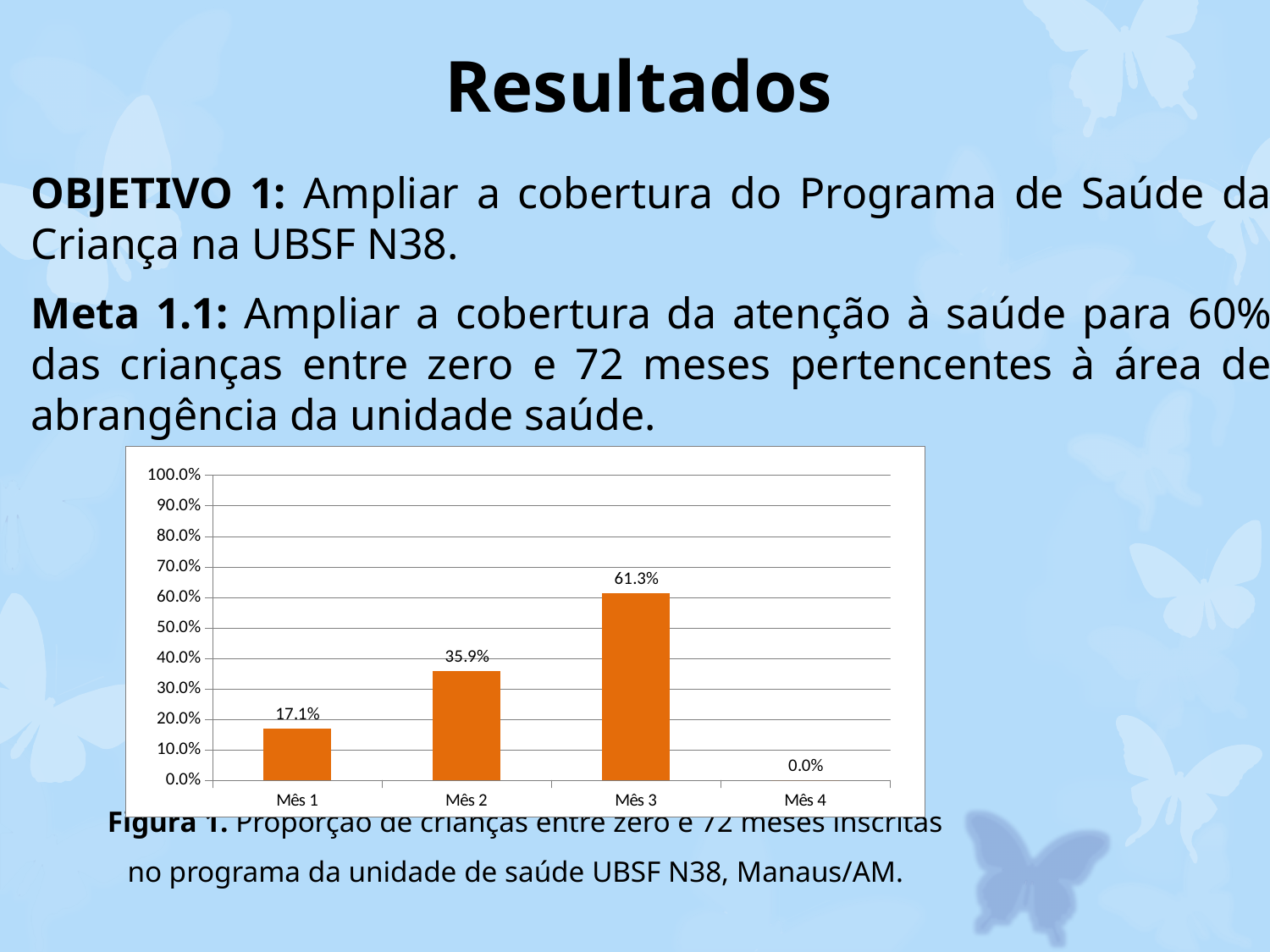
Which is larger, the value for Mês 1 or the value for Mês 2? Mês 2 What is the value for Mês 1? 17.1% What is the value for Mês 4? 0.0% How many months are shown on the x axis? 4 Which month has the lowest value? Mês 4 What is the value for Mês 2? 35.9% Is the value for Mês 3 greater or less than 50.0%? greater What is the difference between the values for Mês 2 and Mês 1? 18.8% What is the difference between the values for Mês 3 and Mês 2? 25.4% Which month has the highest value? Mês 3 What kind of chart is shown on the slide? bar chart What is the value for Mês 3? 61.3%